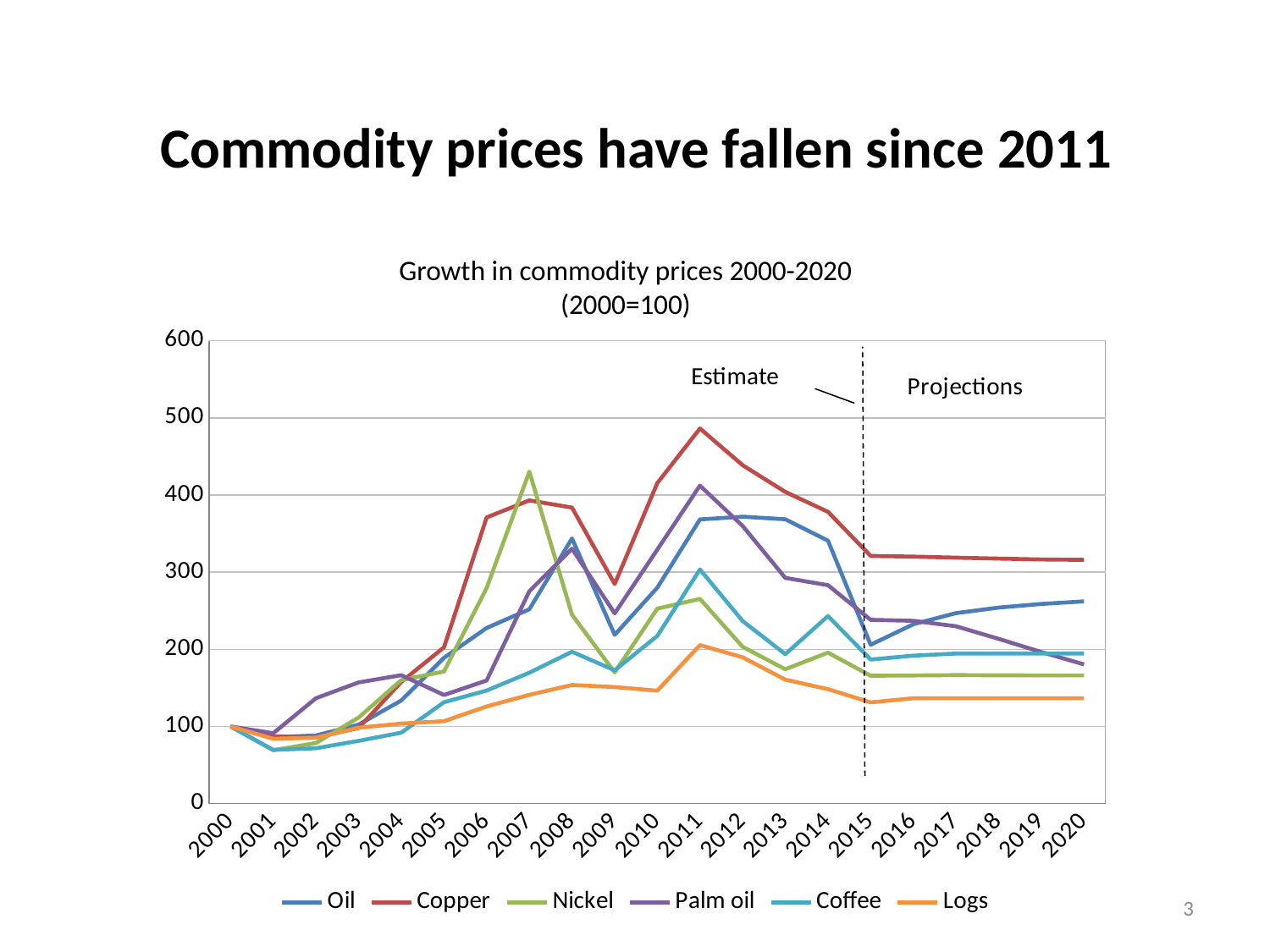
Which commodity has the highest value in 2020? Copper What is the index value of all commodities in 2000? 100 Does the Copper line rise or fall from 2011 to 2015? Fall What kind of chart is shown on the slide? Line chart How many years are shown along the x axis? 21 In 2007, which is larger, Nickel or Logs? Nickel Which commodity has the highest value in 2011? Copper What is the title of the chart? Growth in commodity prices 2000-2020 (2000=100) Is the value for Logs in 2020 greater or less than 200? less How many series does the legend list? 6 Which commodity has the lowest value in 2011? Logs Is the value for Copper in 2011 greater or less than 400? greater